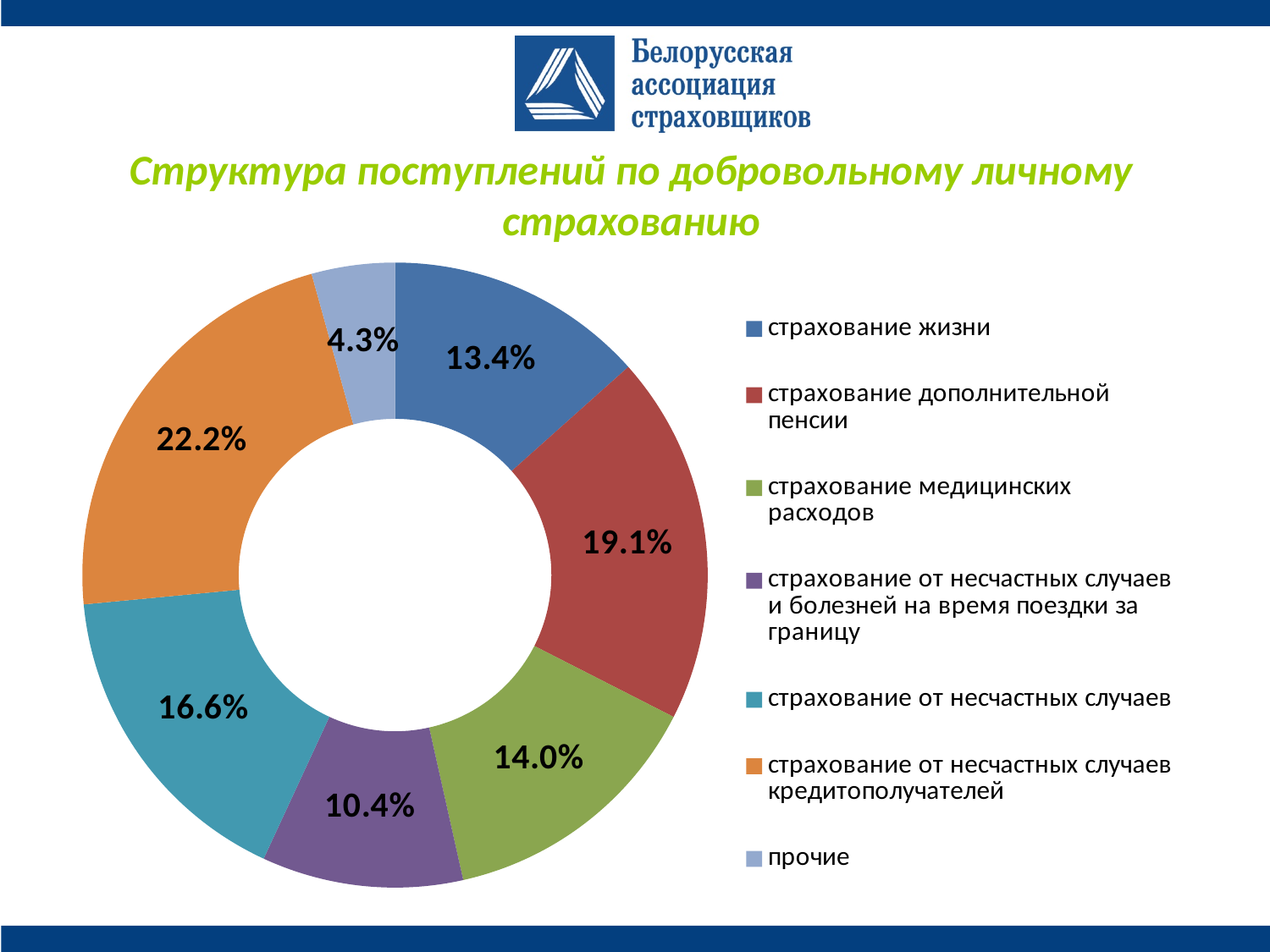
What percentage is shown for страхование медицинских расходов? 14.0% Which category has the smallest share of the chart? прочие Which is larger: the share for страхование дополнительной пенсии or the share for страхование жизни? страхование дополнительной пенсии What is the value shown for страхование дополнительной пенсии? 19.1% What is the difference between the shares of страхование от несчастных случаев кредитополучателей and страхование от несчастных случаев? 5.6% What share of receipts does страхование жизни account for? 13.4% What share is labelled for прочие? 4.3% What is the title of the chart on the slide? Структура поступлений по добровольному личному страхованию What type of chart is shown on the slide? Doughnut chart How many categories are shown in the chart? 7 Which category has the largest share of the chart? страхование от несчастных случаев кредитополучателей What is the value for страхование от несчастных случаев и болезней на время поездки за границу? 10.4%